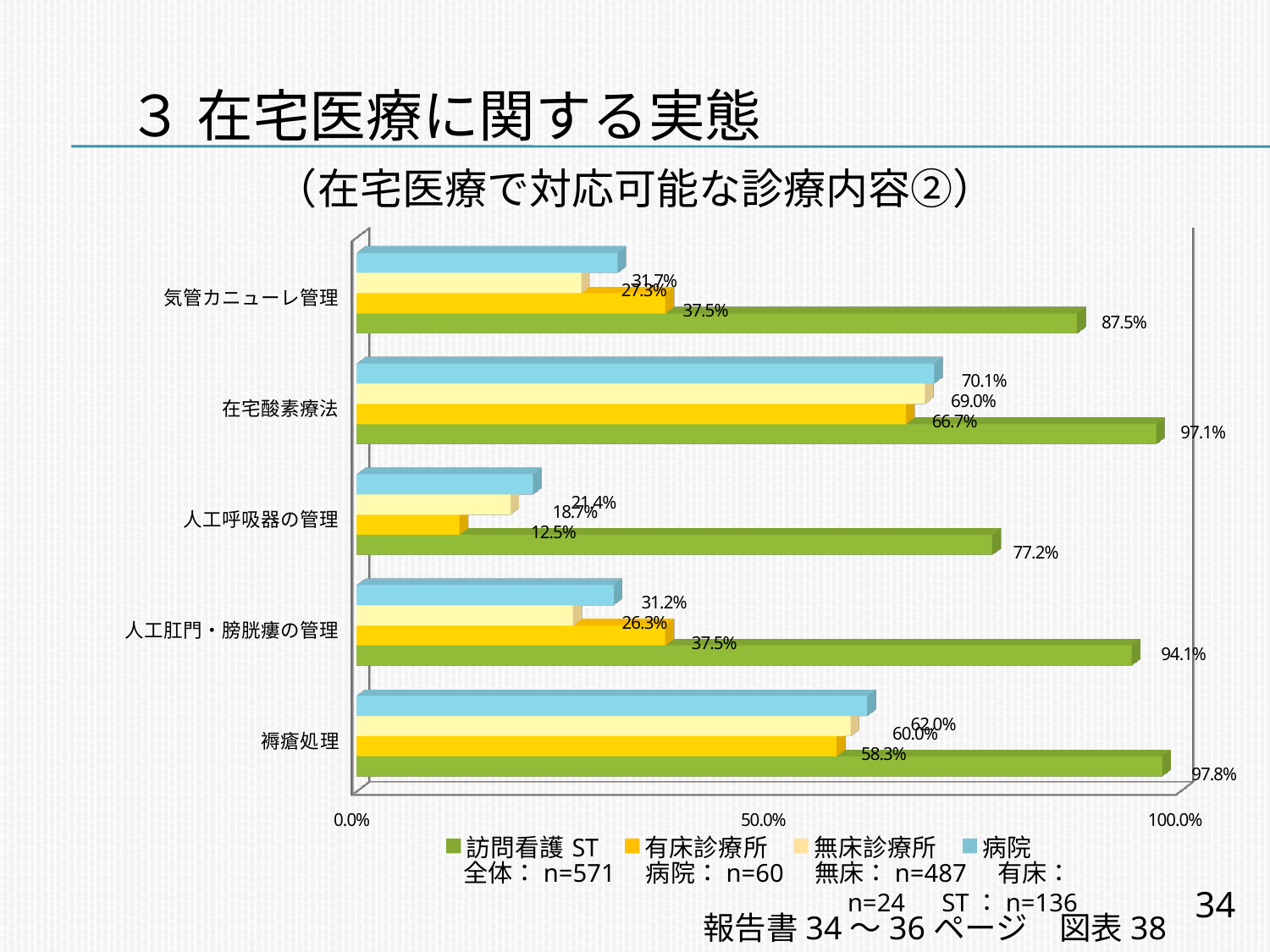
Which category has the lowest value for 有床診療所? 人工呼吸器の管理 In the 在宅酸素療法 category, which is larger: the value for 病院 or the value for 有床診療所? 病院 What is the value for 訪問看護 ST in the 在宅酸素療法 category? 97.1% What is the value for 無床診療所 in the 褥瘡処理 category? 60.0% What type of chart is shown on the slide? bar chart Which category has the highest value for 訪問看護 ST? 褥瘡処理 Which series is shown in green in the legend? 訪問看護 ST What is the difference between the 訪問看護 ST value and the 有床診療所 value in the 気管カニューレ管理 category? 50.0% What is the value for 病院 in the 人工肛門・膀胱瘻の管理 category? 31.2% What is the value for 有床診療所 in the 人工呼吸器の管理 category? 12.5% How many series does the legend list? 4 How many categories are plotted on the chart? 5